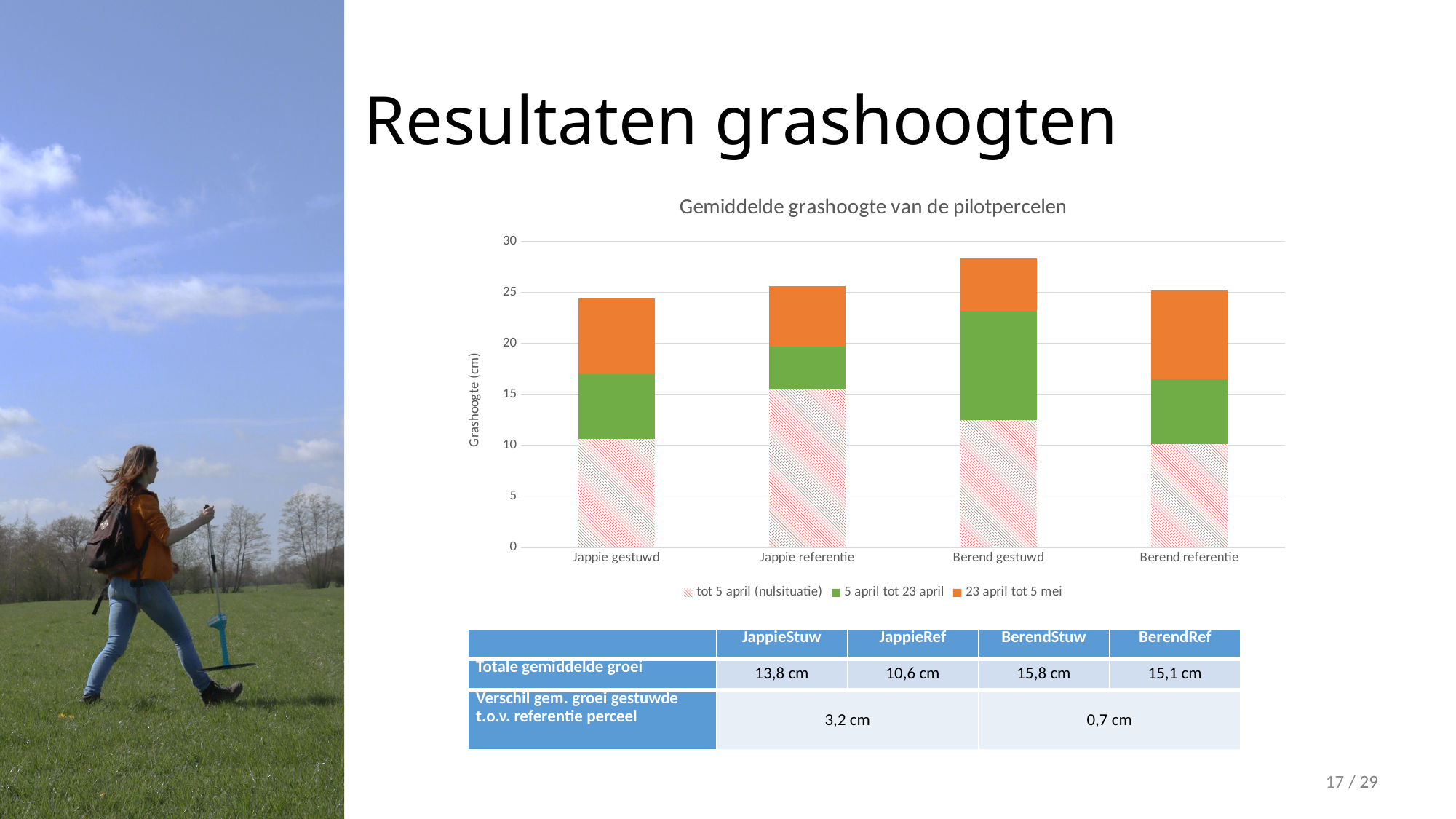
Is the 'tot 5 april (nulsituatie)' segment for Berend gestuwd greater or less than 15? less Is the total stacked bar for Jappie gestuwd greater or less than 25? less How many categories are shown on the x axis of the chart? 4 Which has the larger total stacked bar, Berend gestuwd or Jappie referentie? Berend gestuwd How many series does the chart legend list? 3 Which category has the largest '5 april tot 23 april' segment? Berend gestuwd What is the title of the chart? Gemiddelde grashoogte van de pilotpercelen Is the total stacked bar for Berend gestuwd greater or less than 25? greater Which category has the largest 'tot 5 april (nulsituatie)' segment? Jappie referentie Which category has the highest total stacked bar? Berend gestuwd What type of chart is shown on the slide? Stacked bar chart What is the label of the vertical axis of the chart? Grashoogte (cm)